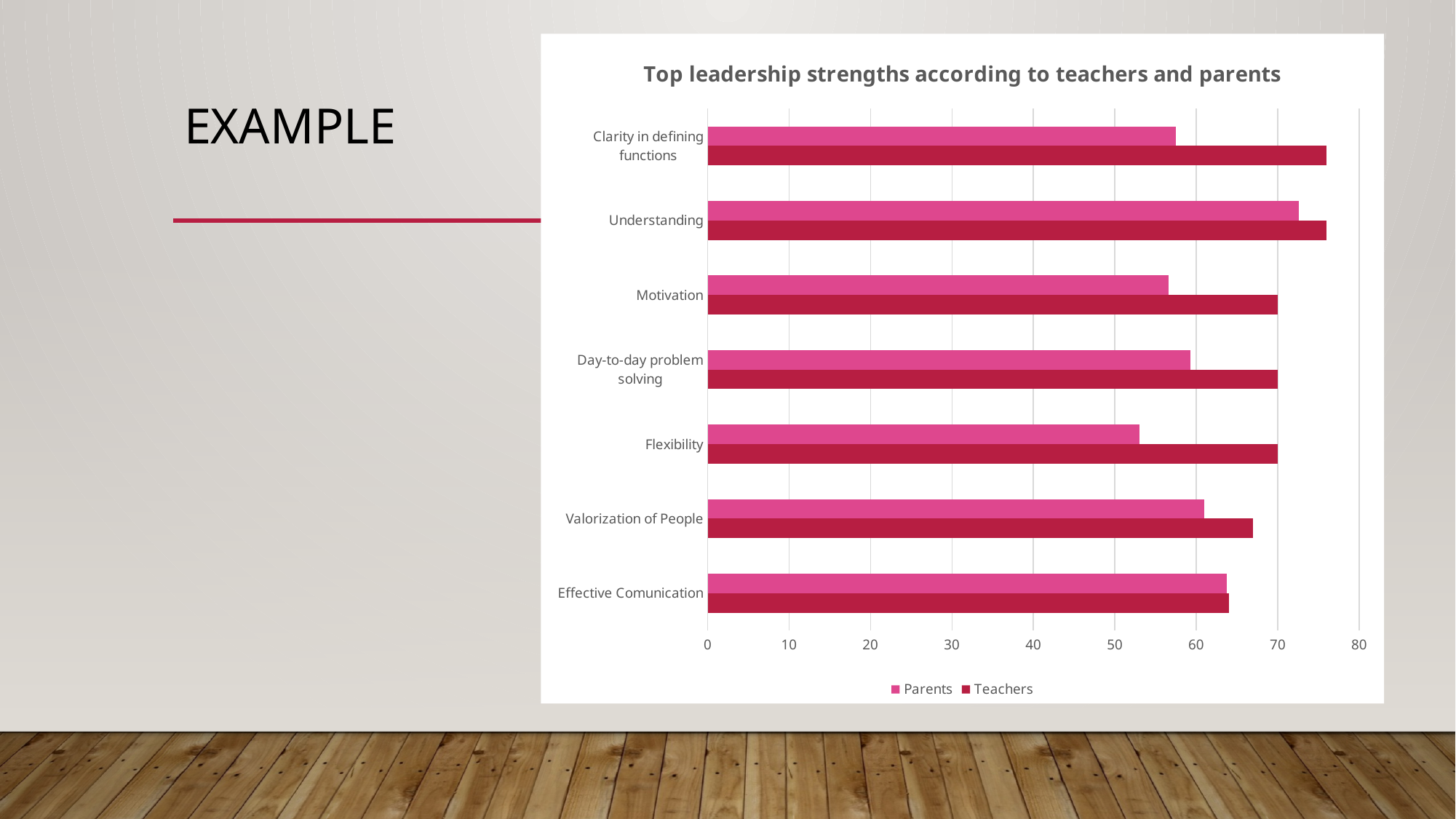
Is the Parents value for Understanding greater or less than 70? greater Which category has the highest value for Parents? Understanding How many leadership strengths (categories) are shown on the chart? 7 Is the Teachers value for Clarity in defining functions greater or less than 70? greater Which category has the lowest value for Parents? Flexibility What type of chart is shown on the slide? Bar chart Which category has the lowest value for Teachers? Effective Comunication How many series does the legend list? 2 What is the title of the chart? Top leadership strengths according to teachers and parents For Flexibility, which is larger: the Parents value or the Teachers value? Teachers Is the Parents value for Flexibility greater or less than 60? less For Understanding, which is larger: the Parents value or the Teachers value? Teachers